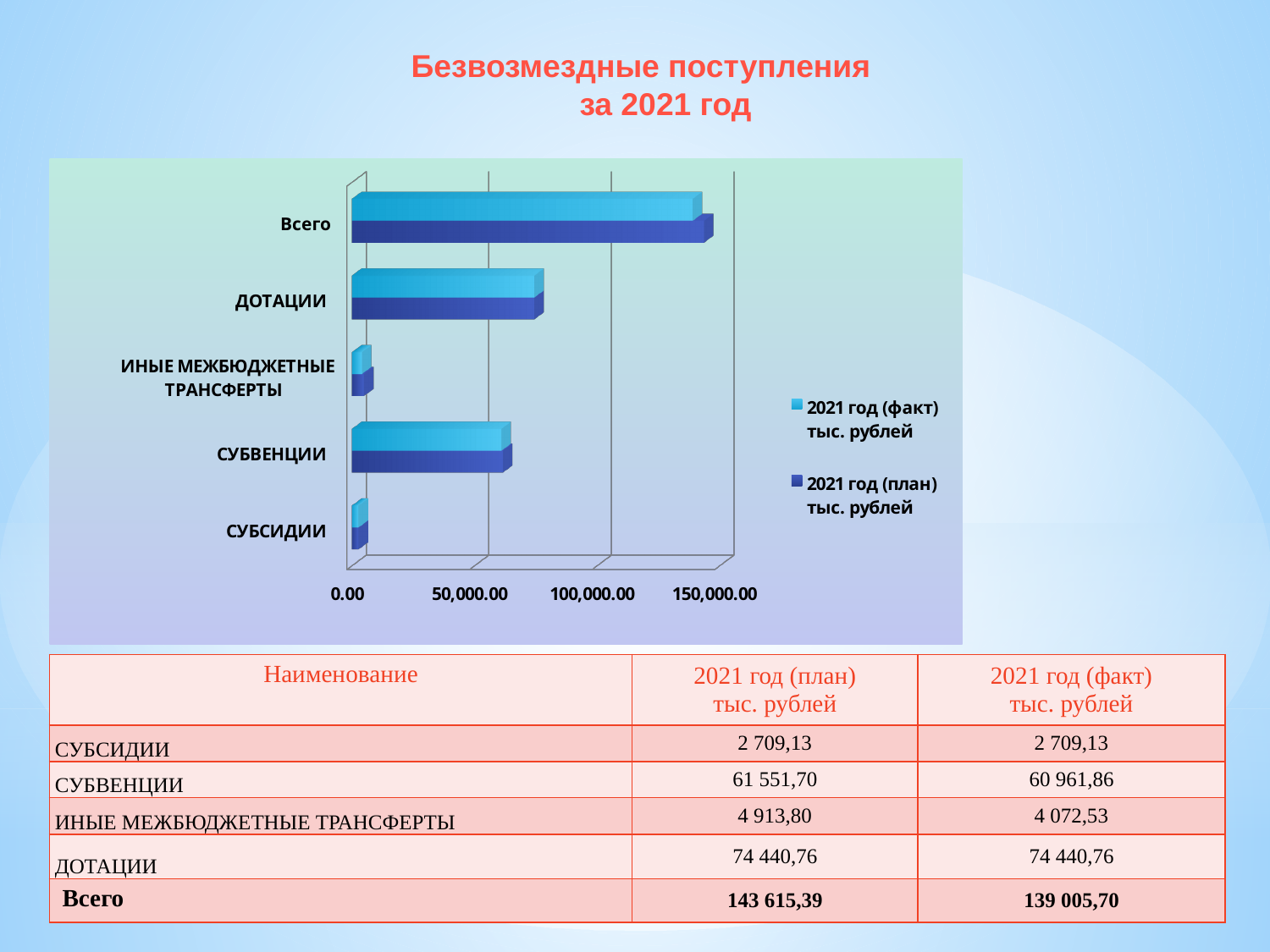
Which category has the longest bars in the chart? Всего According to the table under the chart, what is the 2021 год (план) value for СУБВЕНЦИИ in тыс. рублей? 61 551,70 Is the 2021 год (план) value for ДОТАЦИИ greater or less than 50,000.00? greater Using the table values, what is the difference between the 2021 год (план) and 2021 год (факт) values for Всего, in тыс. рублей? 4 609,69 Is the 2021 год (факт) value for Всего greater or less than 150,000.00? less Which is larger in the chart: the bar for ДОТАЦИИ or the bar for СУБВЕНЦИИ? ДОТАЦИИ What is the title of the slide above the chart? Безвозмездные поступления за 2021 год Is the 2021 год (факт) value for СУБСИДИИ greater or less than 50,000.00? less According to the table under the chart, what is the 2021 год (факт) value for ИНЫЕ МЕЖБЮДЖЕТНЫЕ ТРАНСФЕРТЫ in тыс. рублей? 4 072,53 What kind of chart is shown on the slide? bar chart How many series does the chart legend list? 2 How many categories are plotted on the chart's vertical axis? 5